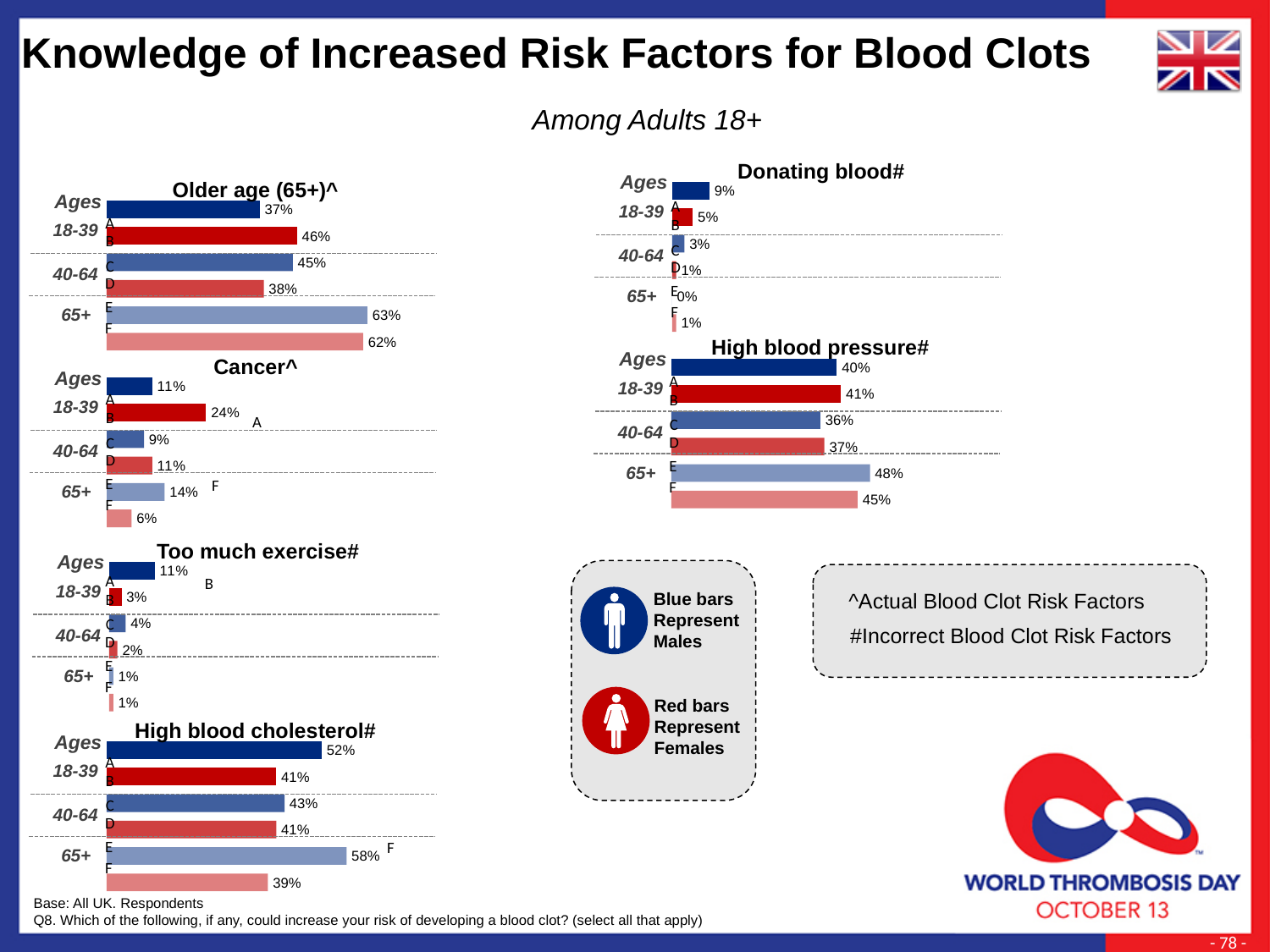
What type of chart is used for 'High blood pressure#'? Bar chart In the 'Cancer^' chart, what is the value for females aged 18-39? 24% In the 'Older age (65+)^' chart, which is larger for ages 18-39: the male value or the female value? Female (46%) In the 'High blood cholesterol#' chart, which bar has the highest value? Males aged 65+ (58%) In the 'Older age (65+)^' chart, what percentage of males aged 65+ identified older age as a risk factor? 63% In the 'High blood cholesterol#' chart, what is the difference between males and females aged 65+? 19 percentage points In the 'Too much exercise#' chart, what is the difference between males and females aged 18-39? 8 percentage points How many age groups are shown in each chart on the slide? 3 In the 'High blood pressure#' chart, what is the value for females aged 40-64? 37% According to the legend on the slide, what do the red bars represent? Females In the 'Donating blood#' chart, what is the value for males aged 65+? 0% In the 'Cancer^' chart, which bar has the lowest value? Females aged 65+ (6%)